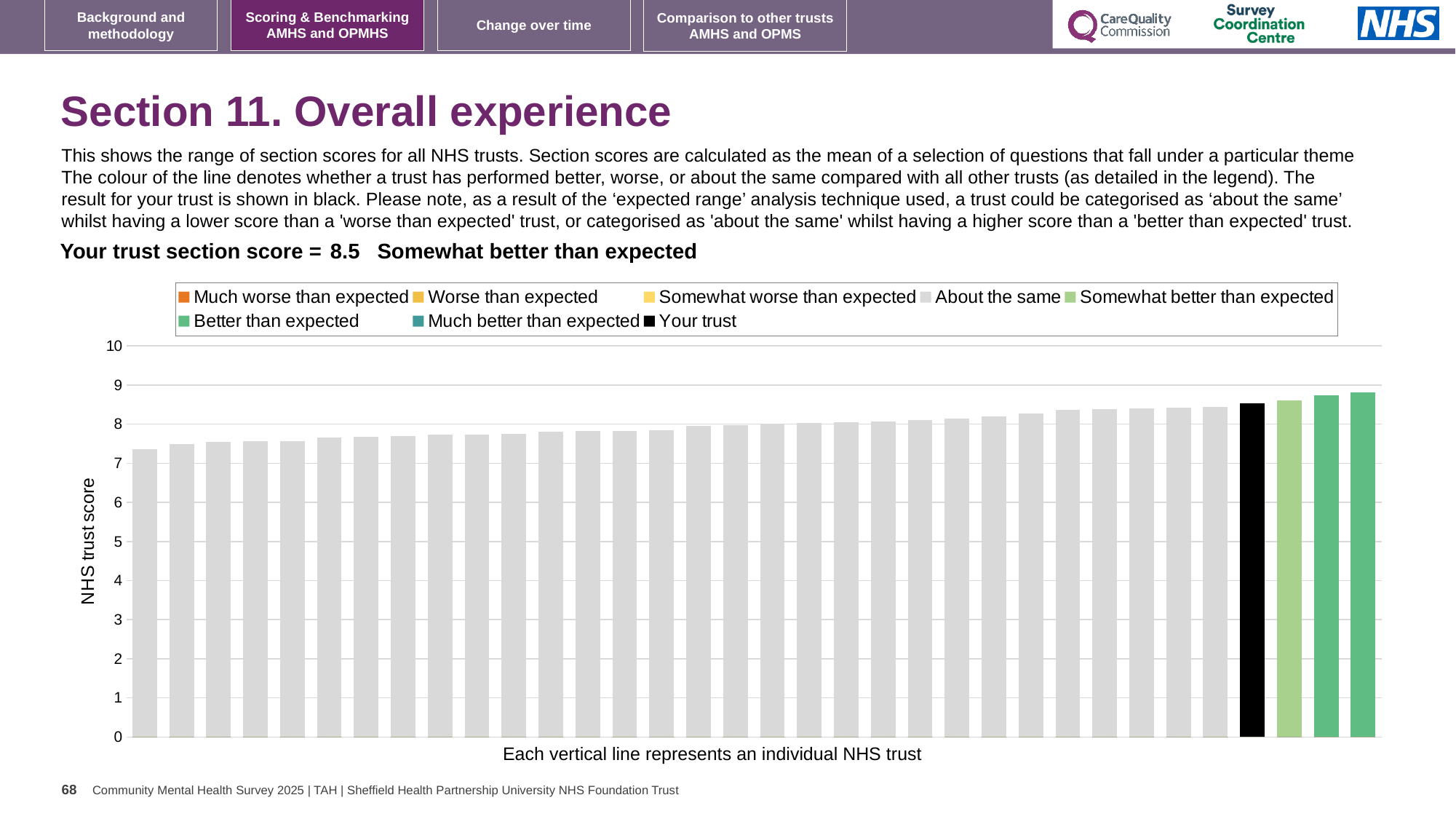
Is the value of the rightmost bar greater or less than 8? greater How many entries does the chart legend list? 8 Is the value of the leftmost bar greater or less than 7? greater Which category does your trust fall into for this section? Somewhat better than expected What kind of chart is shown on the slide? bar chart Which bar is the highest in the chart: the leftmost bar or the rightmost bar? the rightmost bar Is the value of the leftmost bar greater or less than 8? less How many bars are shown to the right of the black 'Your trust' bar? 3 Do the bar values rise or fall from left to right along the x axis? rise What is the section score for your trust? 8.5 What is the title of the vertical axis? NHS trust score What colour is the bar representing your trust? black